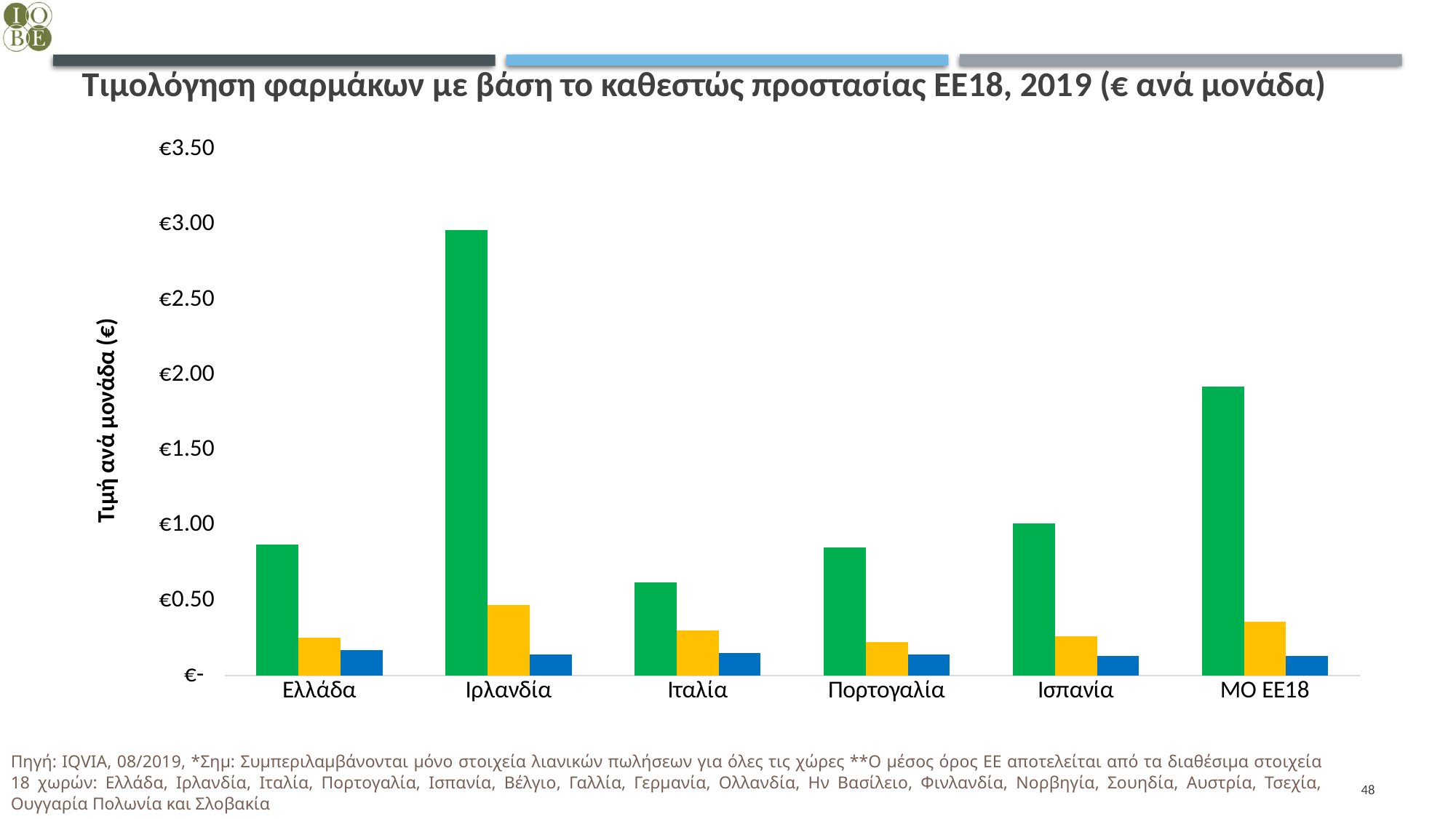
Which category has the tallest yellow bar? Ιρλανδία Is the green bar for Ελλάδα greater or less than €1.00? less Which has the taller green bar, Ιρλανδία or ΜΟ ΕΕ18? Ιρλανδία What is the label of the y axis of the chart? Τιμή ανά μονάδα (€) How many bars are plotted for each category on the chart? 3 How many categories are shown on the x axis of the chart? 6 What type of chart is shown on the slide? Bar chart Which category has the tallest green bar? Ιρλανδία Is the green bar for Ιταλία greater or less than €0.50? greater Is the green bar for ΜΟ ΕΕ18 greater or less than €1.50? greater Which category has the shortest green bar? Ιταλία